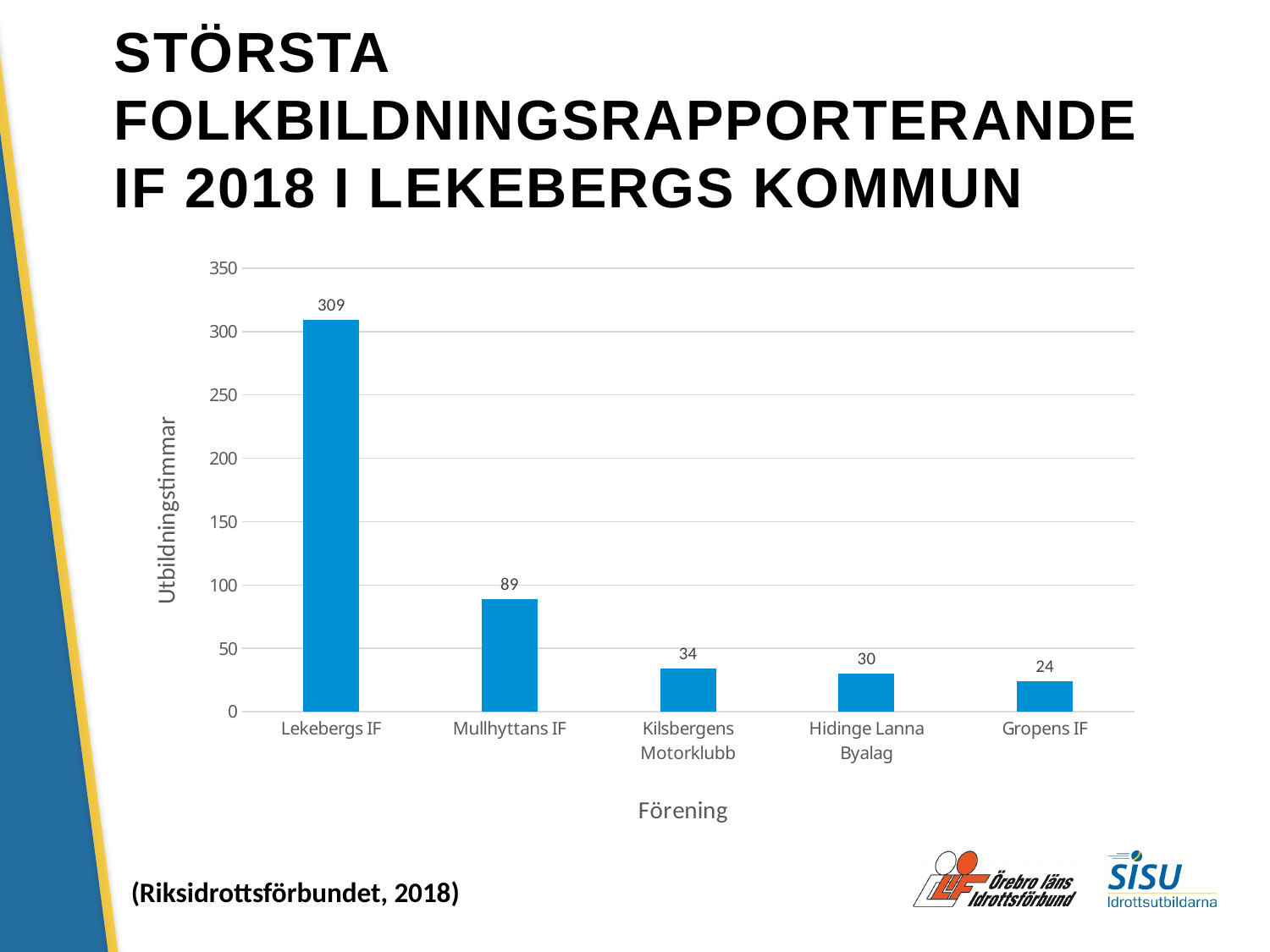
What is the difference between the values for Lekebergs IF and Mullhyttans IF? 220 How many föreningar are shown on the chart? 5 Which is larger, the value for Kilsbergens Motorklubb or the value for Hidinge Lanna Byalag? Kilsbergens Motorklubb What kind of chart is shown on the slide? Bar chart What is the value for Gropens IF? 24 What is the value for Kilsbergens Motorklubb? 34 What is the value for Mullhyttans IF? 89 What is the label of the vertical axis? Utbildningstimmar What is the value for Hidinge Lanna Byalag? 30 Which förening has the lowest number of utbildningstimmar? Gropens IF Which förening has the highest number of utbildningstimmar? Lekebergs IF What is the value for Lekebergs IF? 309